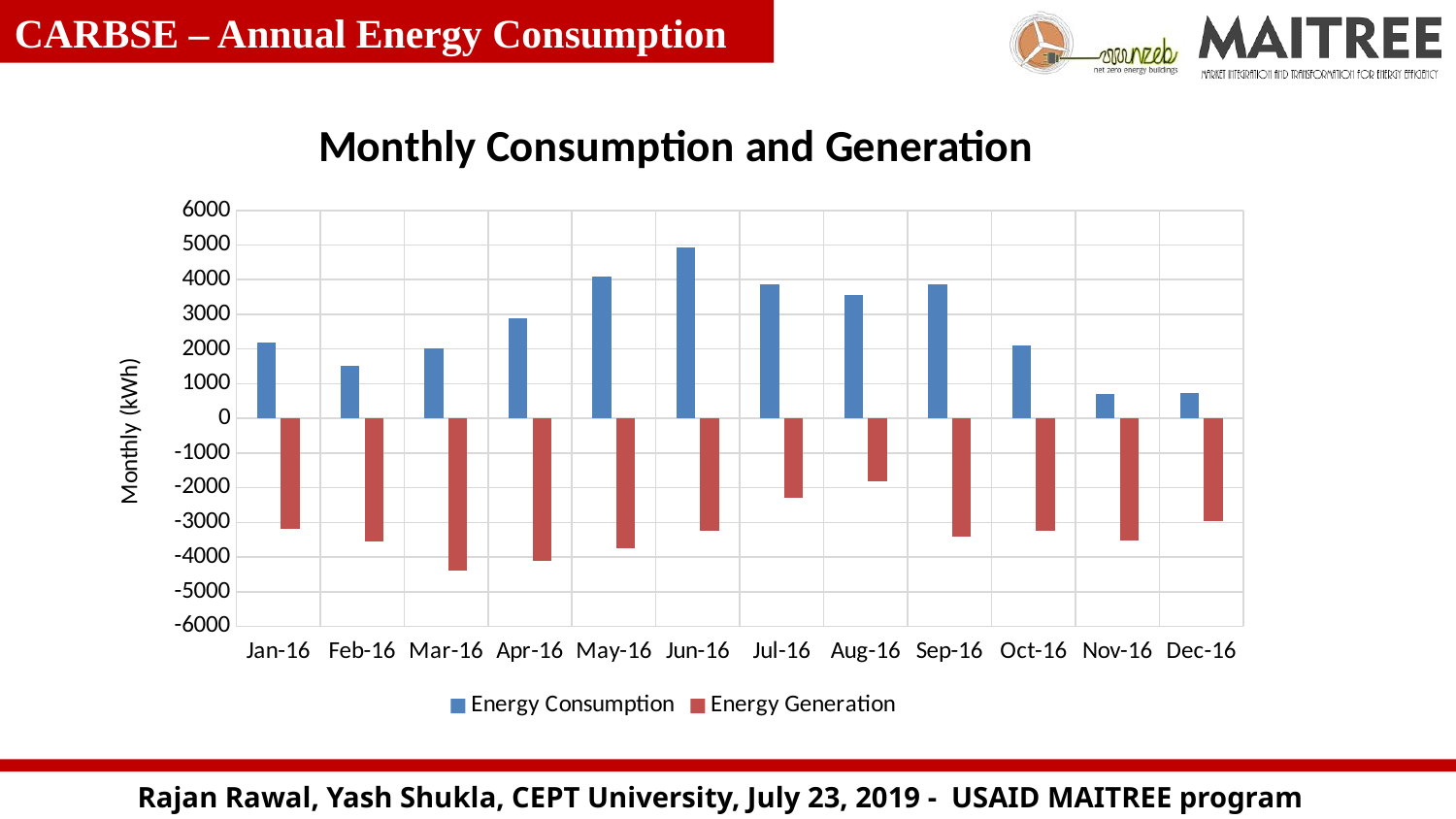
Which month has the larger Energy Consumption, Apr-16 or May-16? May-16 Is the Energy Generation value for Mar-16 greater or less than -4000? less How many months are shown on the x axis? 12 Is the Energy Consumption value for Nov-16 greater or less than 1000? less Which month has the Energy Generation bar closest to zero (smallest generation)? Aug-16 Which month has the highest Energy Consumption? Jun-16 What kind of chart is shown on the slide? Bar chart How many series does the legend list? 2 Is the Energy Generation value for Aug-16 greater or less than -2000? greater From Feb-16 to Jun-16, does Energy Consumption rise or fall? rise What is the label on the y axis of the chart? Monthly (kWh)